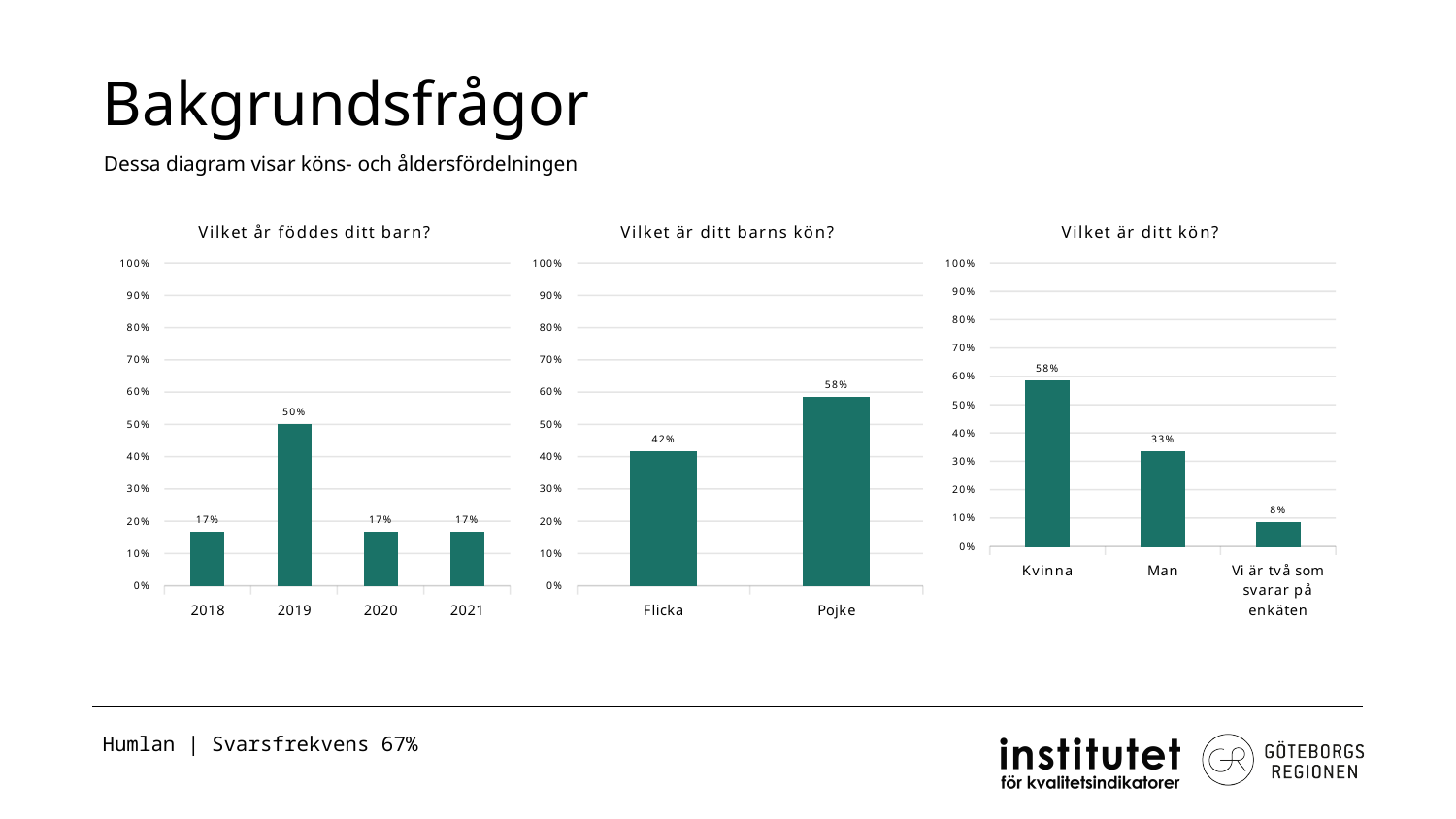
In the chart 'Vilket är ditt barns kön?', which category has the higher value, Flicka or Pojke? Pojke In the chart 'Vilket år föddes ditt barn?', which year has the highest value? 2019 In the chart 'Vilket år föddes ditt barn?', what is the value for 2019? 50% In the chart 'Vilket år föddes ditt barn?', what is the difference between the values for 2019 and 2018? 33% In the chart 'Vilket är ditt kön?', is the value for Kvinna greater or less than 50%? greater How many charts are shown on the slide? 3 In the chart 'Vilket är ditt barns kön?', what is the value for Flicka? 42% In the chart 'Vilket är ditt barns kön?', what is the difference between the values for Pojke and Flicka? 16% What kind of chart is 'Vilket är ditt kön?'? Bar chart In the chart 'Vilket är ditt kön?', which category has the lowest value? Vi är två som svarar på enkäten In the chart 'Vilket är ditt kön?', what is the value for Man? 33% In the chart 'Vilket år föddes ditt barn?', how many years are shown on the x axis? 4